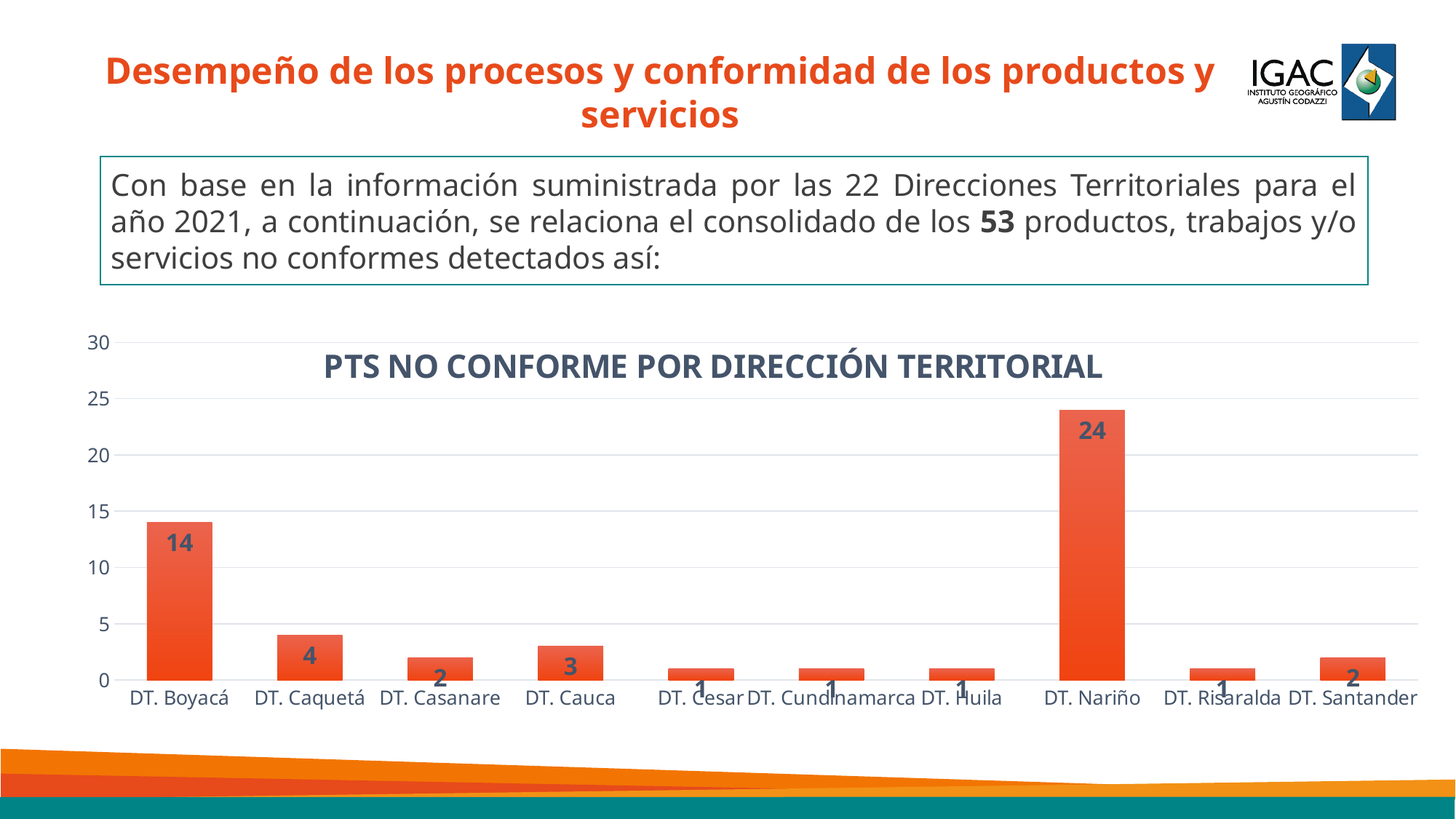
How many direcciones territoriales are shown on the x axis? 10 What is the value for DT. Santander? 2 Is the value for DT. Boyacá greater or less than 10? greater What is the value for DT. Caquetá? 4 What is the value for DT. Nariño? 24 What kind of chart is shown on the slide? Bar chart What is the value for DT. Cauca? 3 Which is larger, the value for DT. Cauca or the value for DT. Caquetá? DT. Caquetá What is the difference between the values for DT. Caquetá and DT. Casanare? 2 Which dirección territorial has the highest value? DT. Nariño What is the value for DT. Boyacá? 14 What is the difference between the values for DT. Nariño and DT. Boyacá? 10